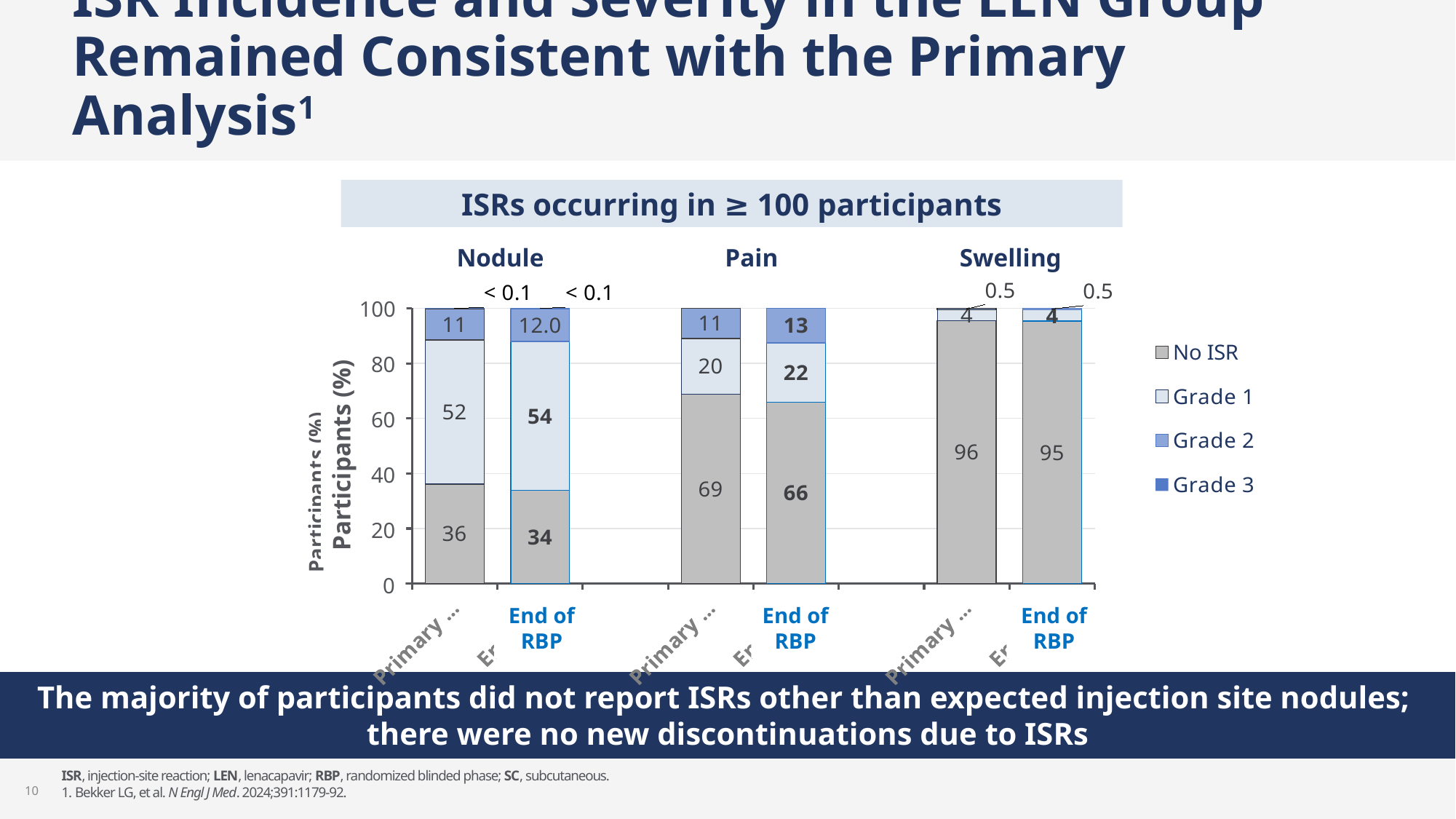
How many stacked bars are plotted in the chart? 6 Is the No ISR value for the Nodule Primary bar greater or less than 40? less What is the No ISR value for the Nodule End of RBP bar? 34 What kind of chart is shown on the slide? Stacked bar chart What is the Grade 1 value for the Pain End of RBP bar? 22 What is the Grade 2 value for the Nodule End of RBP bar? 12.0 What is the difference between the Grade 1 values for Nodule at End of RBP and at Primary? 2 Which ISR type has the highest No ISR value at End of RBP? Swelling What is the No ISR value for the Swelling Primary bar? 96 How many series does the legend list? 4 What is the Grade 3 value shown above the Swelling End of RBP bar? 0.5 For Pain, is the No ISR value larger at Primary or at End of RBP? Primary